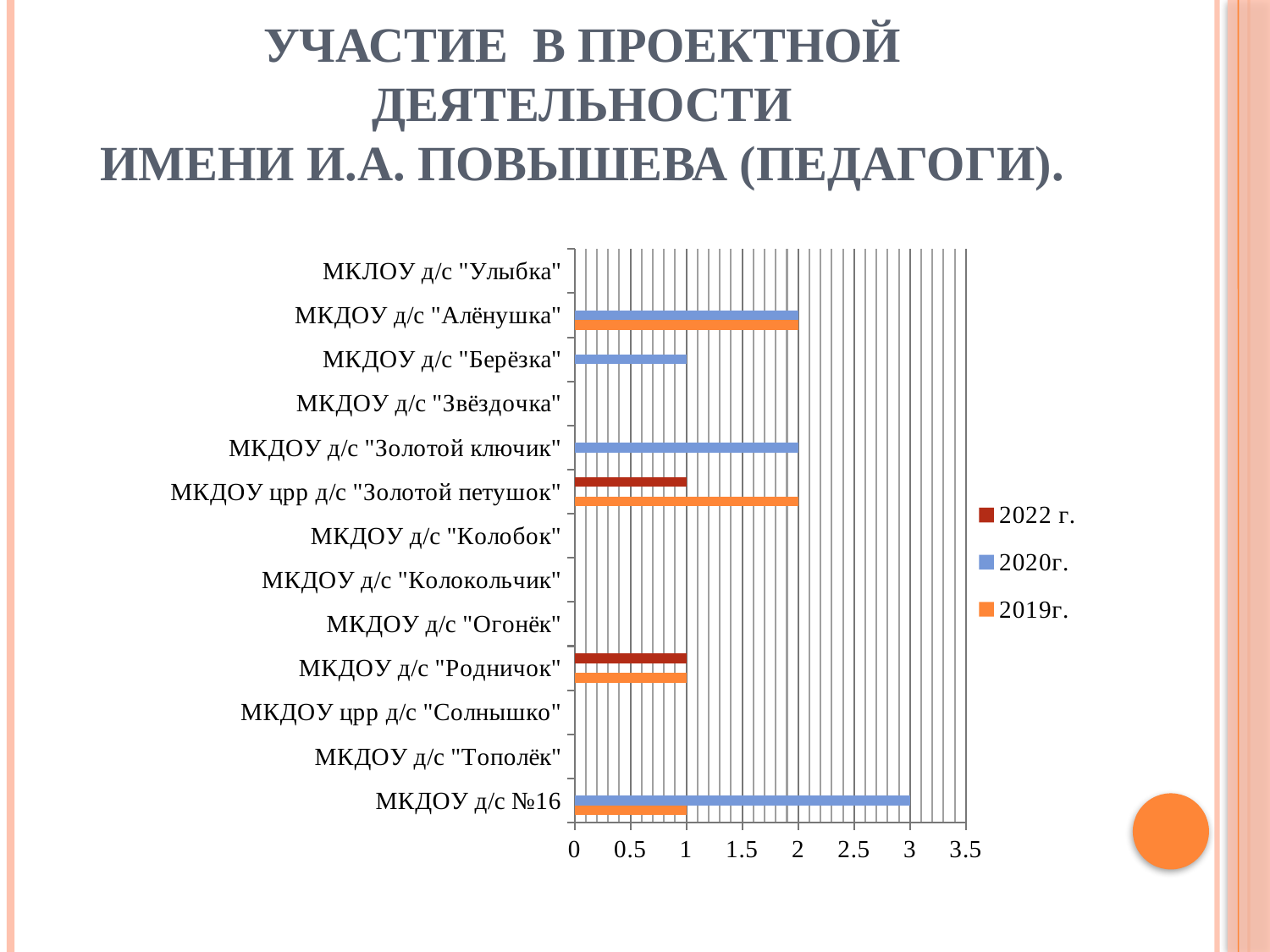
How many categories (institutions) are listed on the vertical axis of the chart? 13 Which is larger for МКДОУ црр д/с "Золотой петушок": the 2022 г. value or the 2019г. value? 2019г. What is the value for МКДОУ д/с №16 in the 2020г. series? 3 How many series does the legend list? 3 Which category has the highest value in the 2020г. series? МКДОУ д/с №16 What is the value for МКДОУ д/с "Алёнушка" in the 2019г. series? 2 What is the difference between the 2020г. value and the 2019г. value for МКДОУ д/с №16? 2 What kind of chart is shown on the slide? bar chart Which legend entry is shown in orange? 2019г. What is the value for МКДОУ црр д/с "Золотой петушок" in the 2022 г. series? 1 Is the 2020г. value for МКДОУ д/с "Золотой ключик" greater or less than 1.5? greater What is the value for МКДОУ д/с "Берёзка" in the 2020г. series? 1